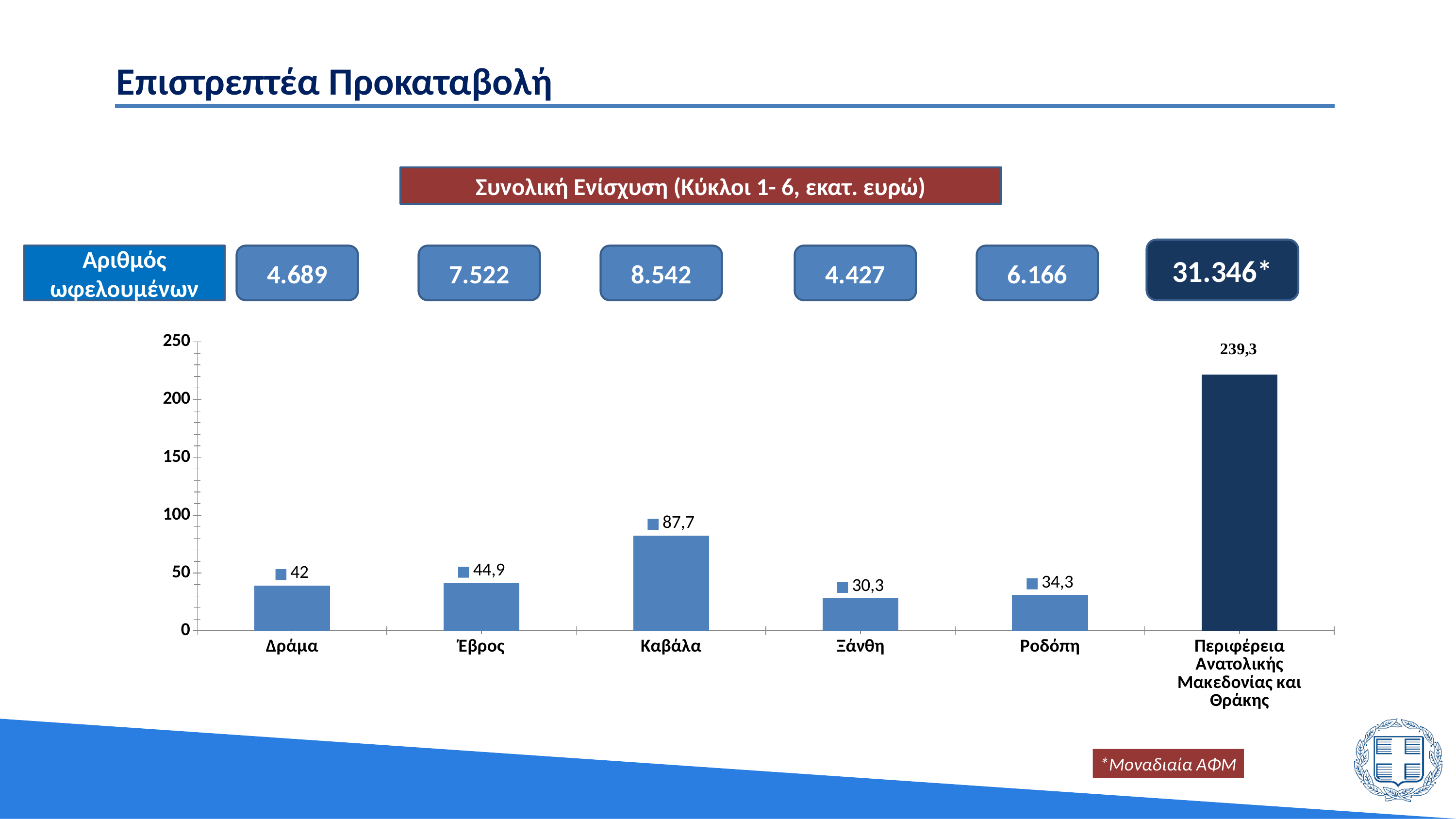
Is the value for Καβάλα greater or less than 50? greater What is the difference between the values for Καβάλα and Έβρος? 42,8 Which has a larger value, Ροδόπη or Ξάνθη? Ροδόπη Which category has the highest value in the chart? Περιφέρεια Ανατολικής Μακεδονίας και Θράκης What is the value for Περιφέρεια Ανατολικής Μακεδονίας και Θράκης in the chart? 239,3 How many categories are shown on the x axis of the chart? 6 What is the title shown above the chart? Συνολική Ενίσχυση (Κύκλοι 1- 6, εκατ. ευρώ) What is the value for Καβάλα in the chart? 87,7 What is the difference between the values for Δράμα and Ξάνθη? 11,7 Which category has the lowest value in the chart? Ξάνθη What is the value for Ξάνθη in the chart? 30,3 What type of chart is shown on the slide? bar chart